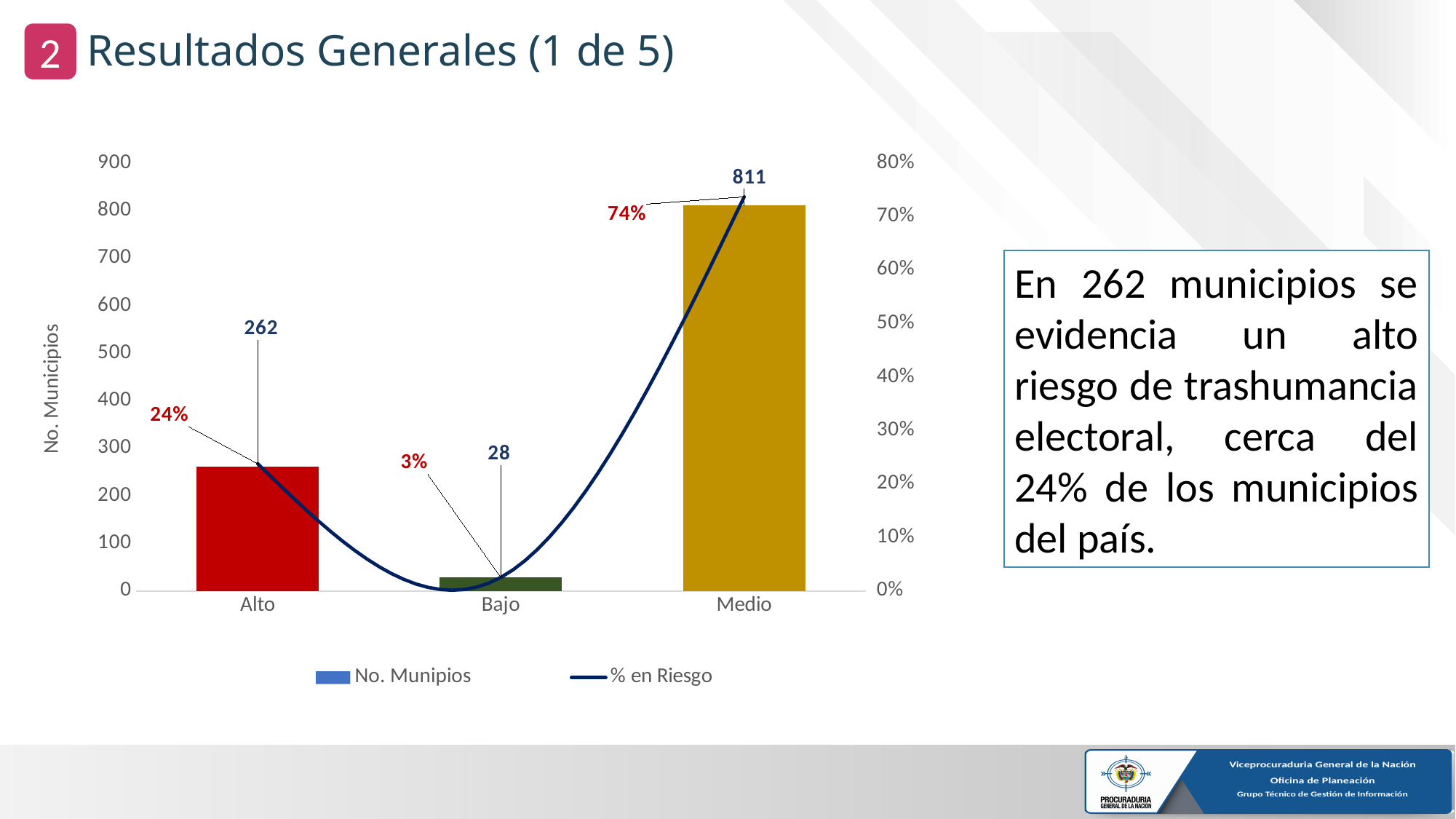
Which category has the highest number of municipalities? Medio How many series does the legend list? 2 What is the total number of municipalities across Alto, Bajo and Medio? 1101 Which has more municipalities, Alto or Bajo? Alto How many categories are shown on the x axis? 3 What is the number of municipalities (No. Munipios) for the Alto category? 262 What is the number of municipalities (No. Munipios) for the Medio category? 811 What is the % en Riesgo value for the Bajo category? 3% What is the % en Riesgo value for the Medio category? 74% Which category has the lowest number of municipalities? Bajo What is the label of the left vertical axis? No. Municipios What is the difference in number of municipalities between Medio and Alto? 549